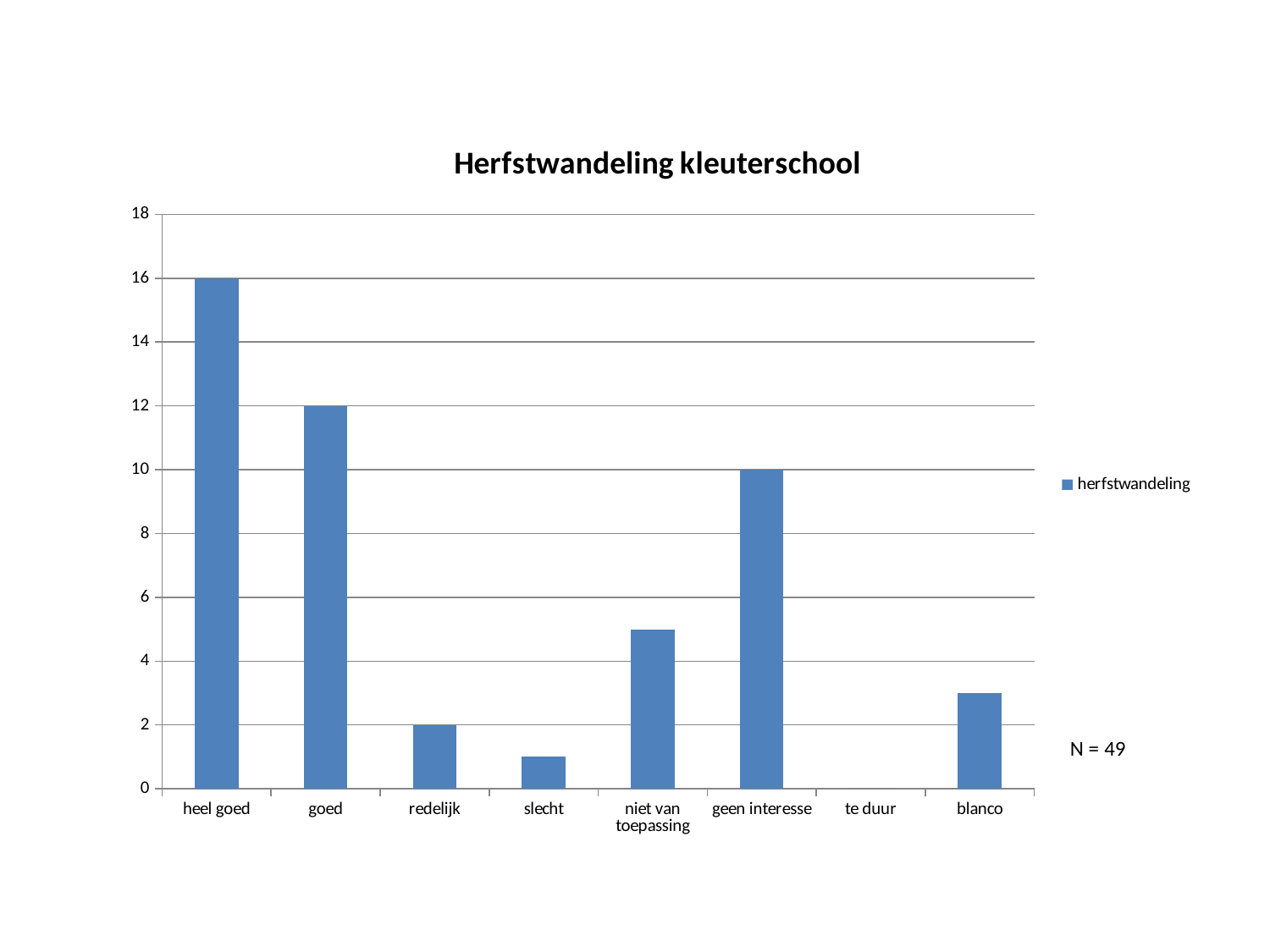
What is the value for 'redelijk'? 2 Which category has the lowest value? te duur Is the value for 'niet van toepassing' greater or less than 4? greater What is the difference between the values for 'heel goed' and 'goed'? 4 What is the value for 'geen interesse'? 10 What kind of chart is shown on the slide? bar chart What is the value for 'heel goed'? 16 Is the value for 'blanco' greater or less than 4? less What is the value for 'goed'? 12 Which is larger, the value for 'goed' or the value for 'geen interesse'? goed Which category has the highest value? heel goed How many categories are shown on the x axis? 8